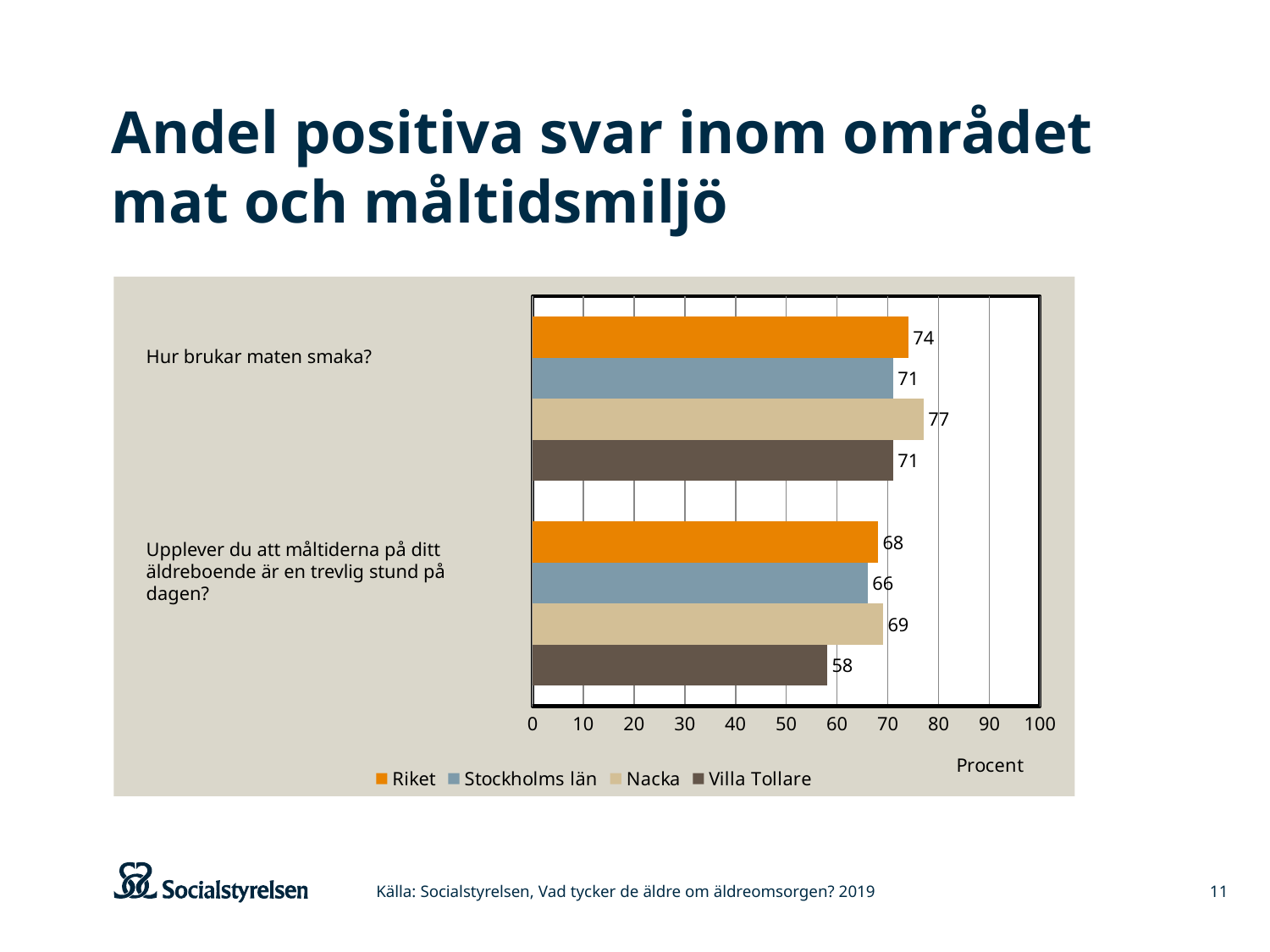
What is the difference between the Nacka and Villa Tollare values on the question "Upplever du att måltiderna på ditt äldreboende är en trevlig stund på dagen?"? 11 How many questions (categories) are shown on the chart? 2 Which is larger: the Riket value for "Hur brukar maten smaka?" or the Riket value for "Upplever du att måltiderna på ditt äldreboende är en trevlig stund på dagen?"? Hur brukar maten smaka? What is the value for Nacka on the question "Hur brukar maten smaka?"? 77 What is the value for Riket on the question "Hur brukar maten smaka?"? 74 What is the label on the horizontal axis of the chart? Procent How many series does the legend list? 4 What kind of chart is shown on the slide? Bar chart What is the value for Stockholms län on the question "Upplever du att måltiderna på ditt äldreboende är en trevlig stund på dagen?"? 66 What is the value for Villa Tollare on the question "Upplever du att måltiderna på ditt äldreboende är en trevlig stund på dagen?"? 58 Which series has the lowest value on the question "Upplever du att måltiderna på ditt äldreboende är en trevlig stund på dagen?"? Villa Tollare Which series has the highest value on the question "Hur brukar maten smaka?"? Nacka